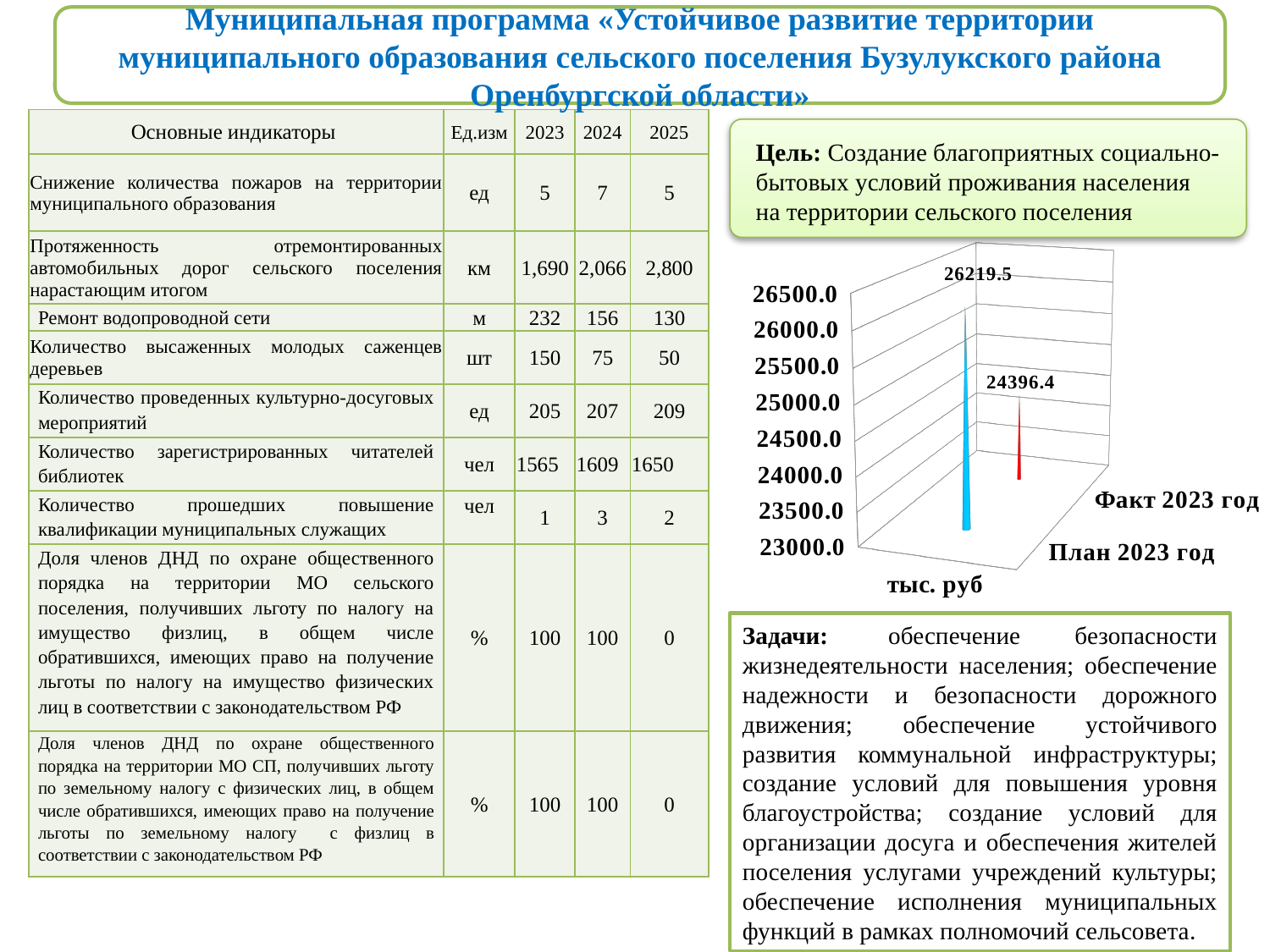
Which category has the lowest value on the chart? Факт 2023 год Which category has the higher value on the chart, План 2023 год or Факт 2023 год? План 2023 год Is the value for Факт 2023 год greater or less than 25000.0? less Is the value for План 2023 год greater or less than 26000.0? greater What is the difference between the values for План 2023 год and Факт 2023 год? 1823.1 What is the value for План 2023 год on the chart? 26219.5 What is the value for Факт 2023 год on the chart? 24396.4 What unit is shown on the chart's axis label? тыс. руб How many categories are plotted on the chart? 2 What is the lowest value shown on the chart's vertical axis? 23000.0 Which category has the highest value on the chart? План 2023 год What kind of chart is shown on the slide? bar chart